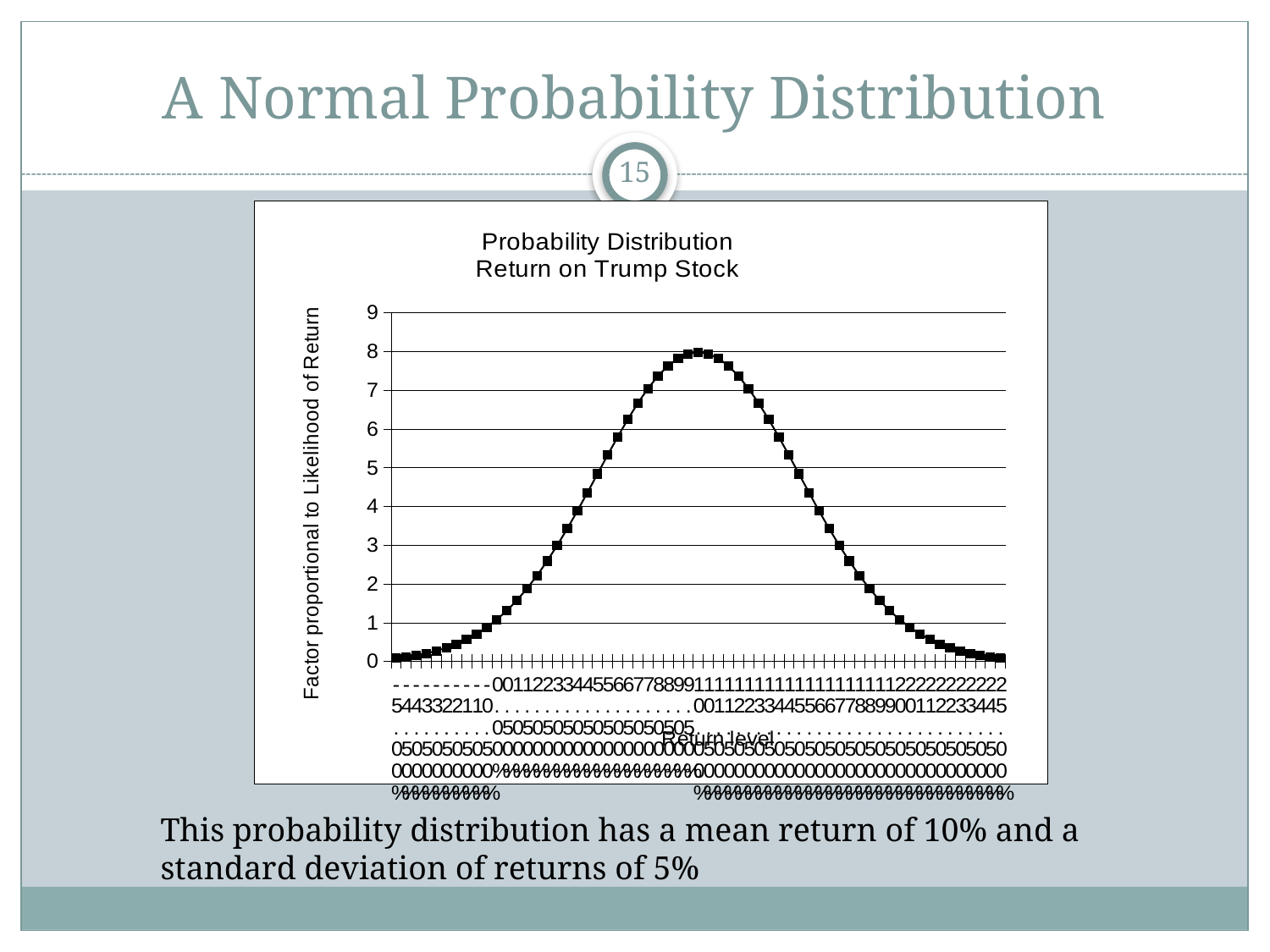
What is the label on the vertical axis of the chart? Factor proportional to Likelihood of Return Do the plotted values rise or fall moving from the left end of the x axis toward the middle? rise Are the values at the far right end of the curve greater or less than 1? less Is the value at the centre of the curve greater or less than the value at the left end? greater Is the highest point of the curve greater or less than 7? greater What is the title of the chart? Probability Distribution Return on Trump Stock Is the highest point of the curve greater or less than 9? less Do the plotted values rise or fall moving from the middle of the x axis toward the right end? fall What kind of chart is shown on the slide? line chart